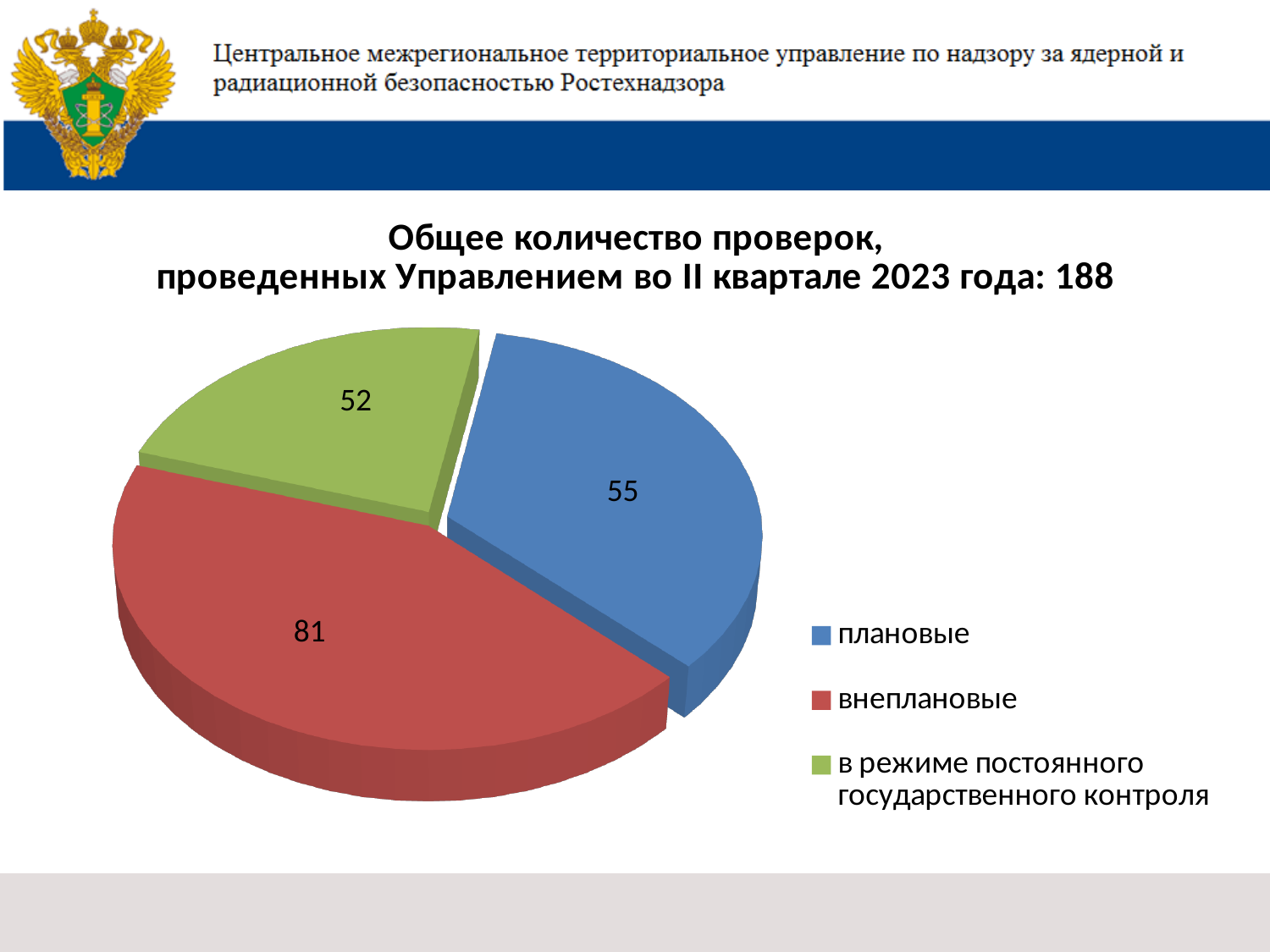
How many checks are shown for в режиме постоянного государственного контроля? 52 What is the difference between the number of внеплановые and плановые checks? 26 What colour is the slice for внеплановые? red What share of the total checks do внеплановые checks represent, to the nearest whole percent? 43% How many categories does the pie chart have? 3 How many checks are shown for внеплановые? 81 What is the difference between the number of плановые checks and checks в режиме постоянного государственного контроля? 3 How many checks are shown for плановые? 55 What type of chart is shown on the slide? pie chart Which is larger: the number of плановые checks or внеплановые checks? внеплановые Which category has the largest slice of the pie? внеплановые Which category has the smallest slice of the pie? в режиме постоянного государственного контроля